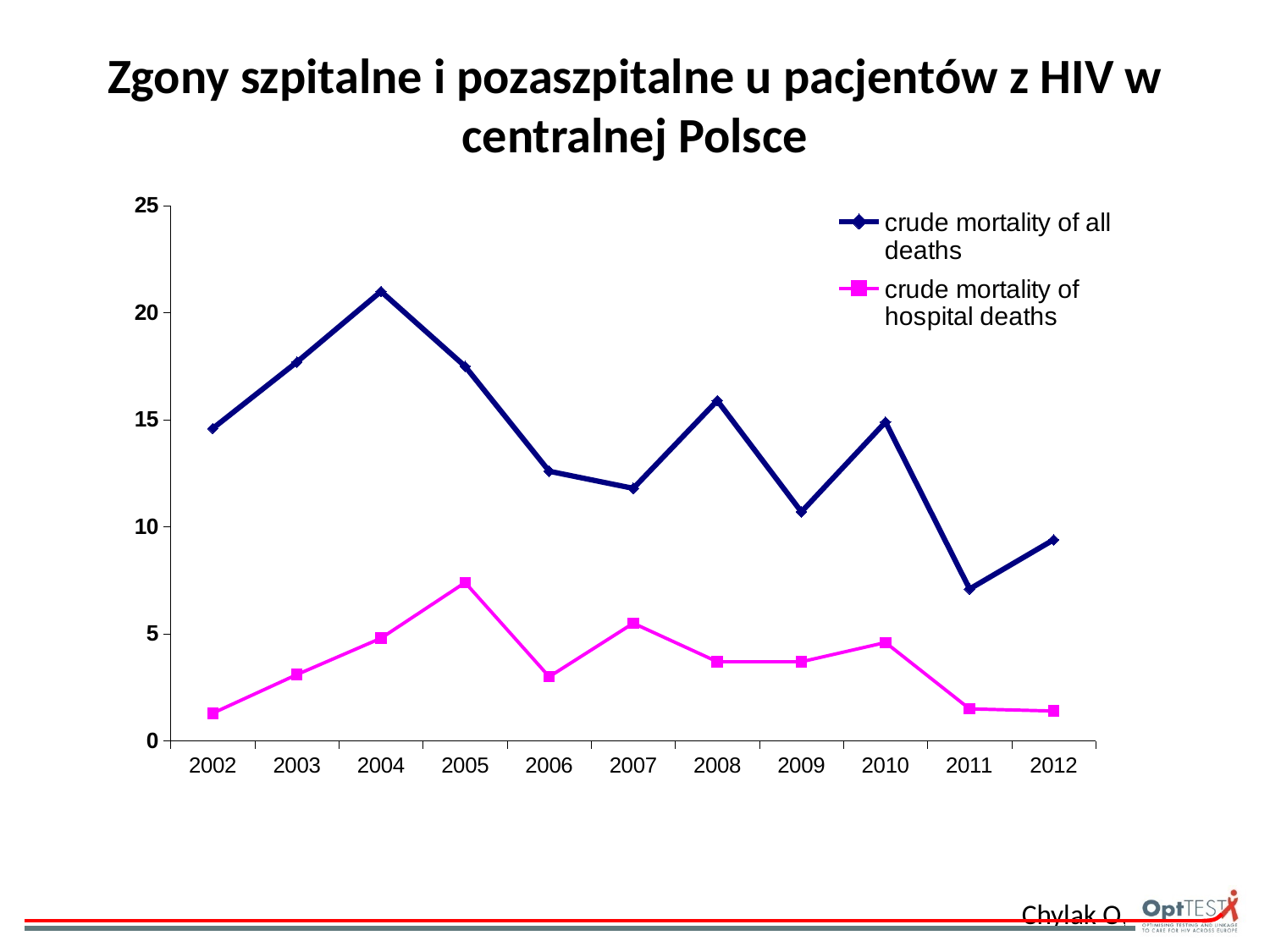
What colour is the line for crude mortality of hospital deaths? magenta (pink) What kind of chart is shown on the slide? line chart In which year is the crude mortality of all deaths highest? 2004 In which year is the crude mortality of hospital deaths highest? 2005 Does the crude mortality of all deaths rise or fall from 2010 to 2011? fall Which year has the higher crude mortality of all deaths, 2004 or 2005? 2004 How many years are plotted along the x axis? 11 In which year is the crude mortality of all deaths lowest? 2011 Is the crude mortality of hospital deaths in 2005 greater or less than 5? greater Is the crude mortality of all deaths in 2011 greater or less than 10? less Is the crude mortality of all deaths in 2004 greater or less than 20? greater How many series does the legend list? 2